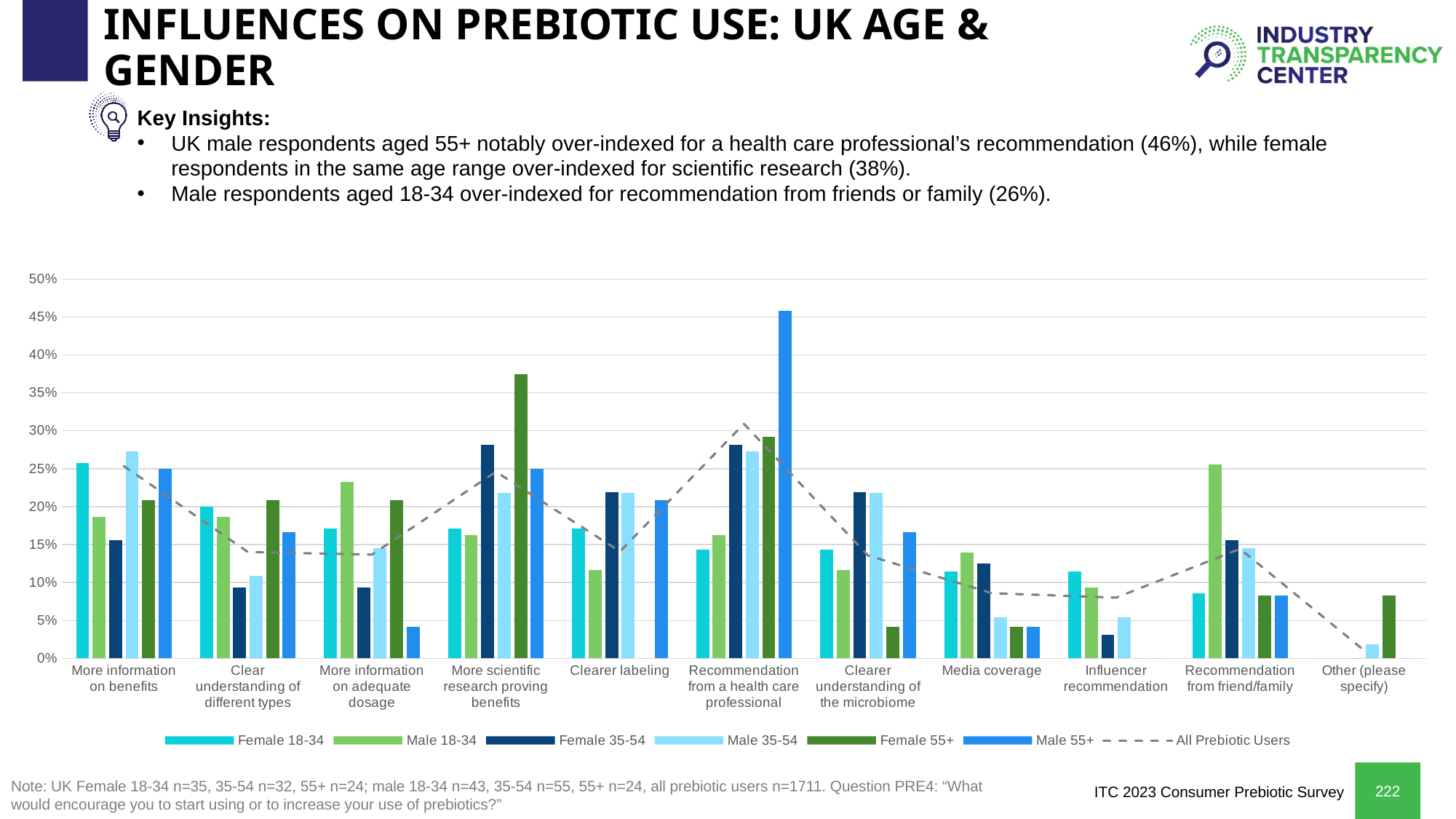
Which series has the highest value for 'Recommendation from friend/family'? Male 18-34 Is the value for Female 55+ under 'More scientific research proving benefits' greater or less than 35%? greater How many categories are shown along the x axis of the chart? 11 Is the value for Male 55+ under 'Recommendation from a health care professional' greater or less than 40%? greater Which series has the lowest value for 'More information on adequate dosage'? Male 55+ Which series is represented by the dashed grey line in the chart? All Prebiotic Users Which category contains the tallest bar in the chart? Recommendation from a health care professional How many series does the chart's legend list? 7 Is the value for Female 35-54 under 'Influencer recommendation' greater or less than 5%? less What kind of chart is shown on the slide? combination bar and line chart Which series has the highest value for 'More scientific research proving benefits'? Female 55+ For 'More information on benefits', which is larger: Female 18-34 or Male 18-34? Female 18-34